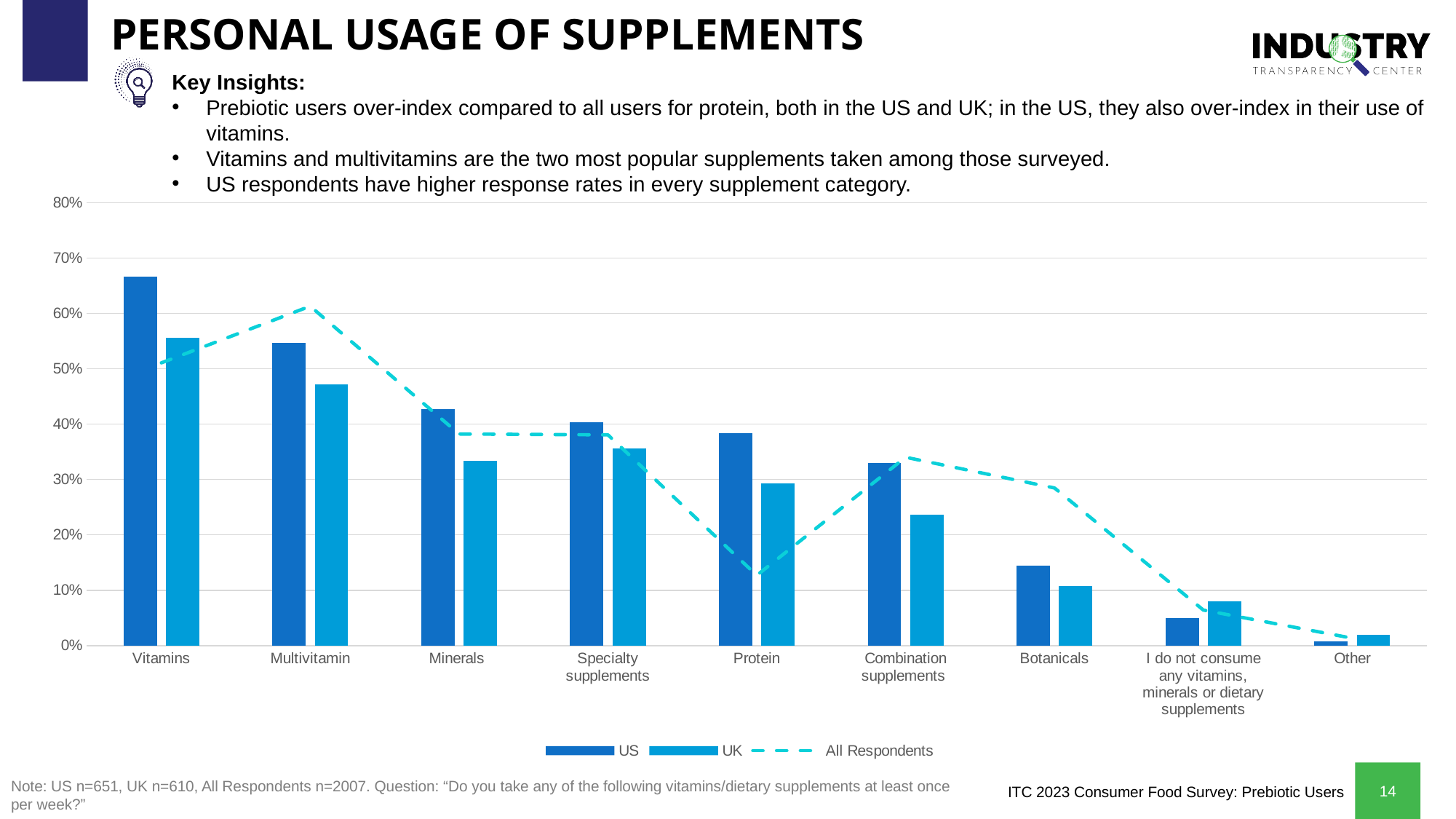
Is the US value for Vitamins greater or less than 60%? greater Is the UK value for Combination supplements greater or less than 20%? greater How many series does the legend list? 3 For Botanicals, which is larger, the US value or the UK value? US Which category has the highest US value? Vitamins How many supplement categories are shown on the x axis? 9 Is the UK value for Botanicals greater or less than 20%? less Which category has the lowest US value? Other Do the US values generally rise or fall moving from Vitamins to Other along the x axis? fall What kind of chart is shown on the slide? Combination bar and line chart For 'I do not consume any vitamins, minerals or dietary supplements', which is larger, the US value or the UK value? UK Which category has the highest UK value? Vitamins